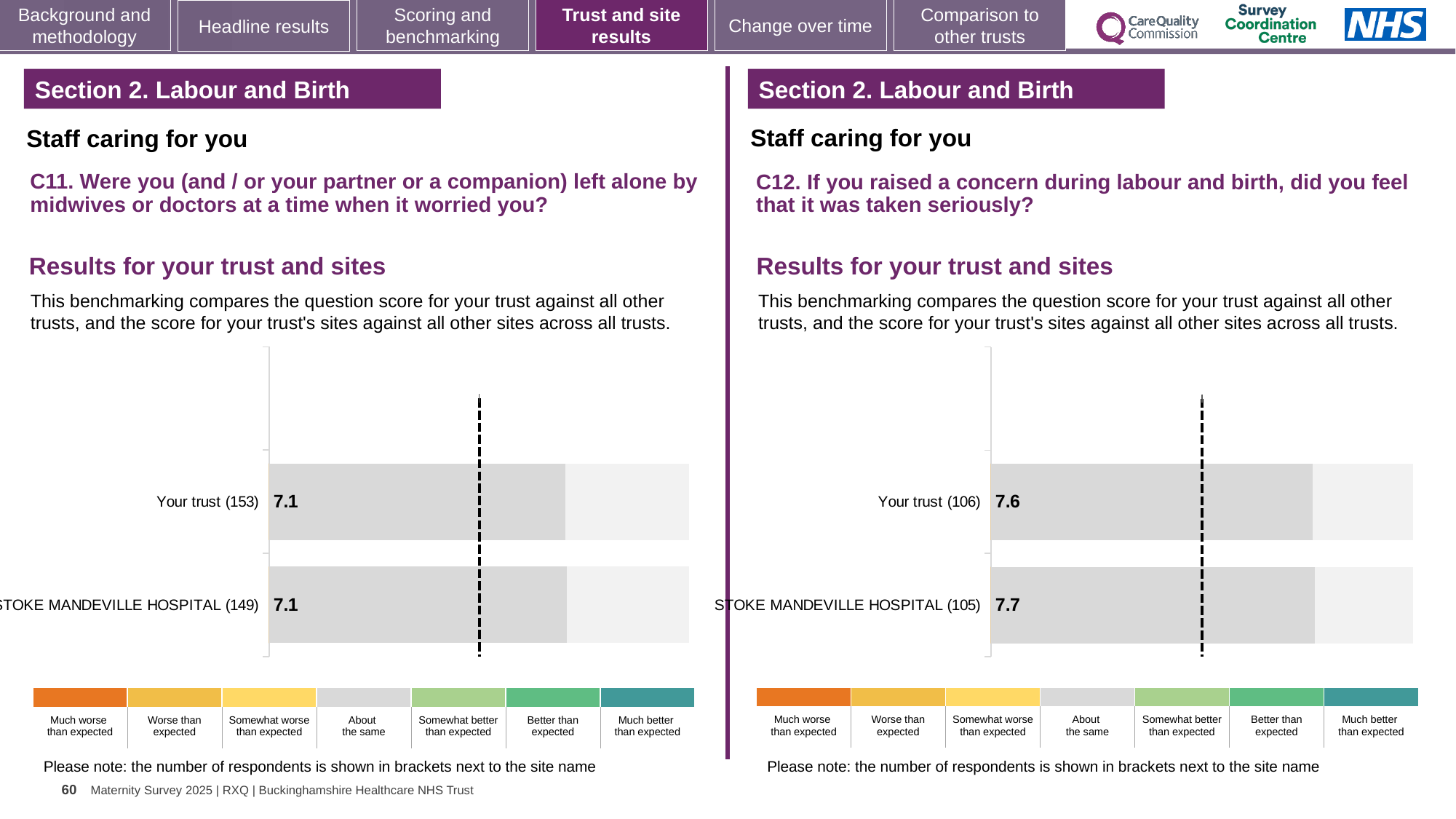
On the left chart (C11), how many respondents are shown in brackets for Your trust? 153 On the left chart (C11), what is the score for Stoke Mandeville Hospital? 7.1 On the right chart (C12), what is the difference between the Stoke Mandeville Hospital score and the Your trust score? 0.1 How many categories does the colour key below each chart list? 7 How many bars are plotted on the left chart (C11)? 2 On the right chart (C12), how many respondents are shown in brackets for Stoke Mandeville Hospital? 105 On the right chart (C12), what is the score for Stoke Mandeville Hospital? 7.7 On the left chart (C11), what is the difference between the Your trust score and the Stoke Mandeville Hospital score? 0 How many bars are plotted on the right chart (C12)? 2 On the left chart (C11), what is the score for Your trust? 7.1 On the right chart (C12), what is the score for Your trust? 7.6 What type of chart is used on the left (C11)? Bar chart